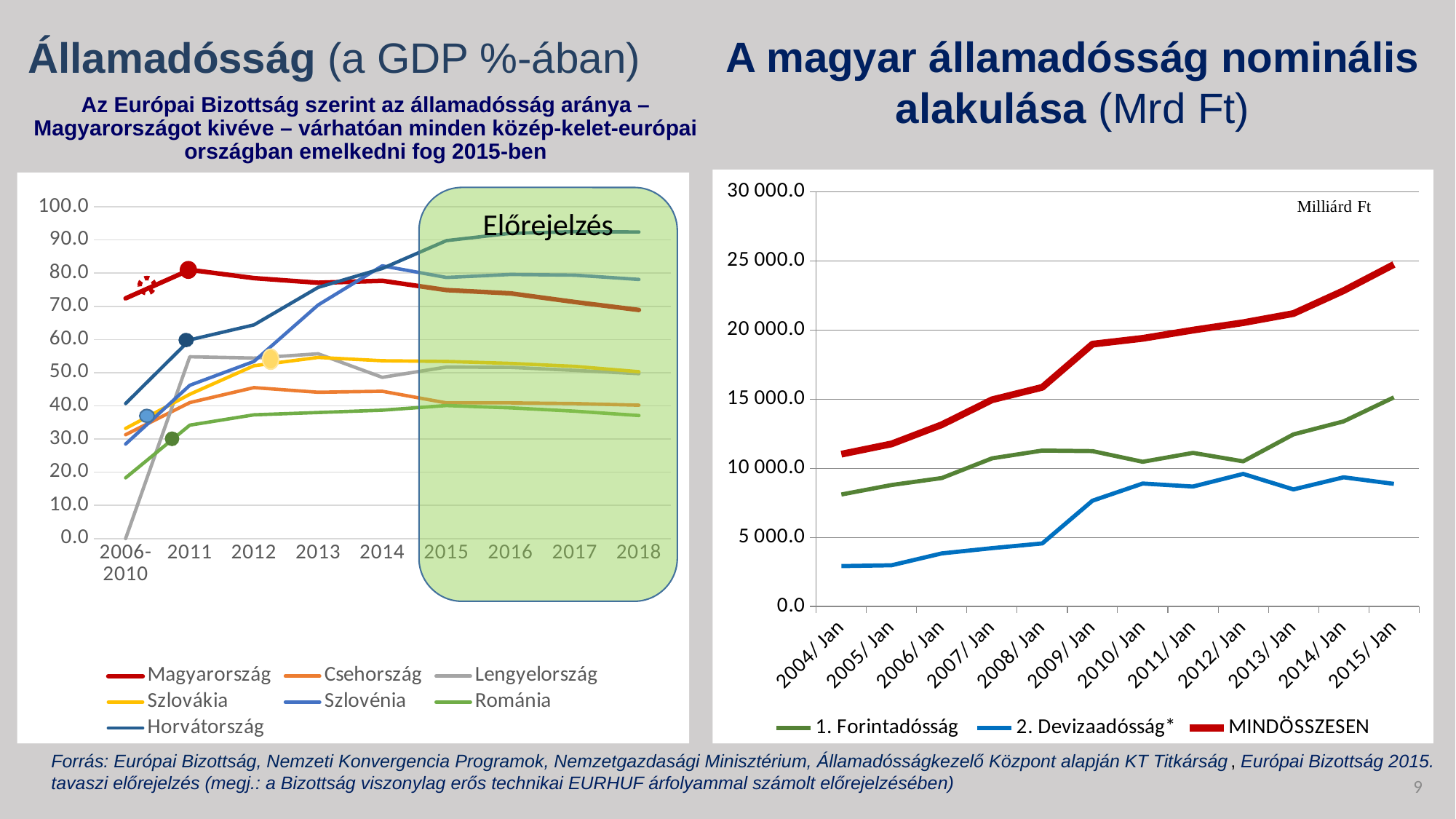
On the left chart (Államadósság a GDP %-ában), what kind of chart is it? line chart On the right chart (A magyar államadósság nominális alakulása), is the value for 2. Devizaadósság* at 2004/Jan greater or less than 5 000.0? less On the right chart (A magyar államadósság nominális alakulása), how many series does the legend list? 3 On the right chart (A magyar államadósság nominális alakulása), does the MINDÖSSZESEN line rise or fall from 2004/Jan to 2015/Jan? rise On the right chart (A magyar államadósság nominális alakulása), how many time points are shown on the x axis? 12 On the left chart (Államadósság a GDP %-ában), does the Magyarország line rise or fall from 2011 to 2018? fall On the right chart (A magyar államadósság nominális alakulása), is the value for MINDÖSSZESEN at 2015/Jan greater or less than 20 000.0? greater On the left chart (Államadósság a GDP %-ában), is the value for Horvátország in 2018 greater or less than 90? greater On the left chart (Államadósság a GDP %-ában), which country has the highest value in 2018? Horvátország On the right chart (A magyar államadósság nominális alakulása), which is larger at 2015/Jan: 1. Forintadósság or 2. Devizaadósság*? 1. Forintadósság On the left chart (Államadósság a GDP %-ában), how many series does the legend list? 7